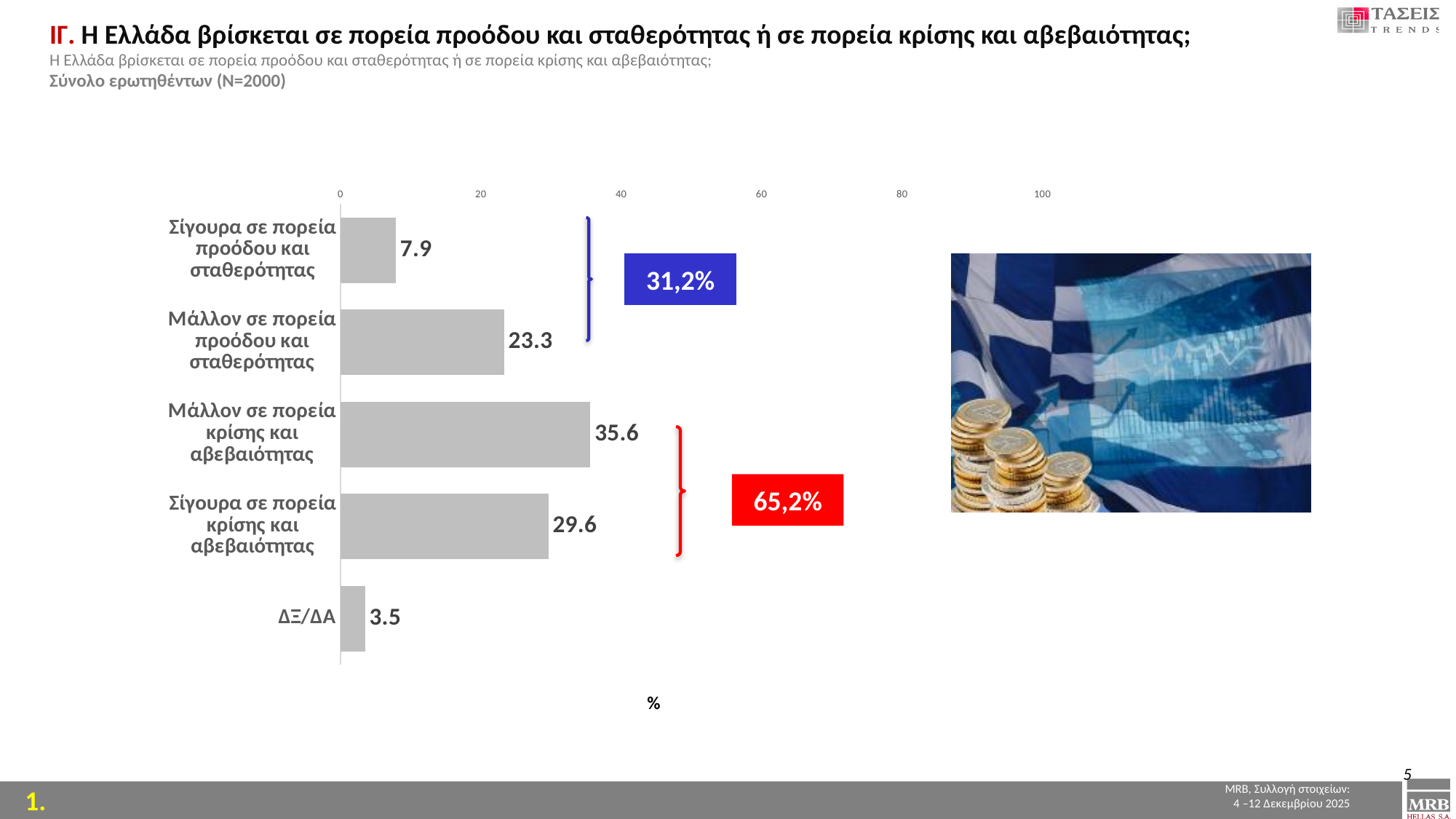
Is the value for "Μάλλον σε πορεία προόδου και σταθερότητας" greater or less than 20? greater Which category has the lowest value? ΔΞ/ΔΑ What is the difference between the values for "Μάλλον σε πορεία κρίσης και αβεβαιότητας" and "Σίγουρα σε πορεία κρίσης και αβεβαιότητας"? 6.0 What is the value for "ΔΞ/ΔΑ"? 3.5 How many categories are shown in the chart? 5 What is the value for "Σίγουρα σε πορεία προόδου και σταθερότητας"? 7.9 What percentage is shown in the red box summarising the two "κρίσης και αβεβαιότητας" categories? 65,2% Which is larger: the value for "Μάλλον σε πορεία προόδου και σταθερότητας" or "Σίγουρα σε πορεία κρίσης και αβεβαιότητας"? Σίγουρα σε πορεία κρίσης και αβεβαιότητας Which category has the highest value? Μάλλον σε πορεία κρίσης και αβεβαιότητας What is the value for "Μάλλον σε πορεία κρίσης και αβεβαιότητας"? 35.6 What percentage is shown in the blue box summarising the two "προόδου και σταθερότητας" categories? 31,2% What kind of chart is shown on the slide? bar chart